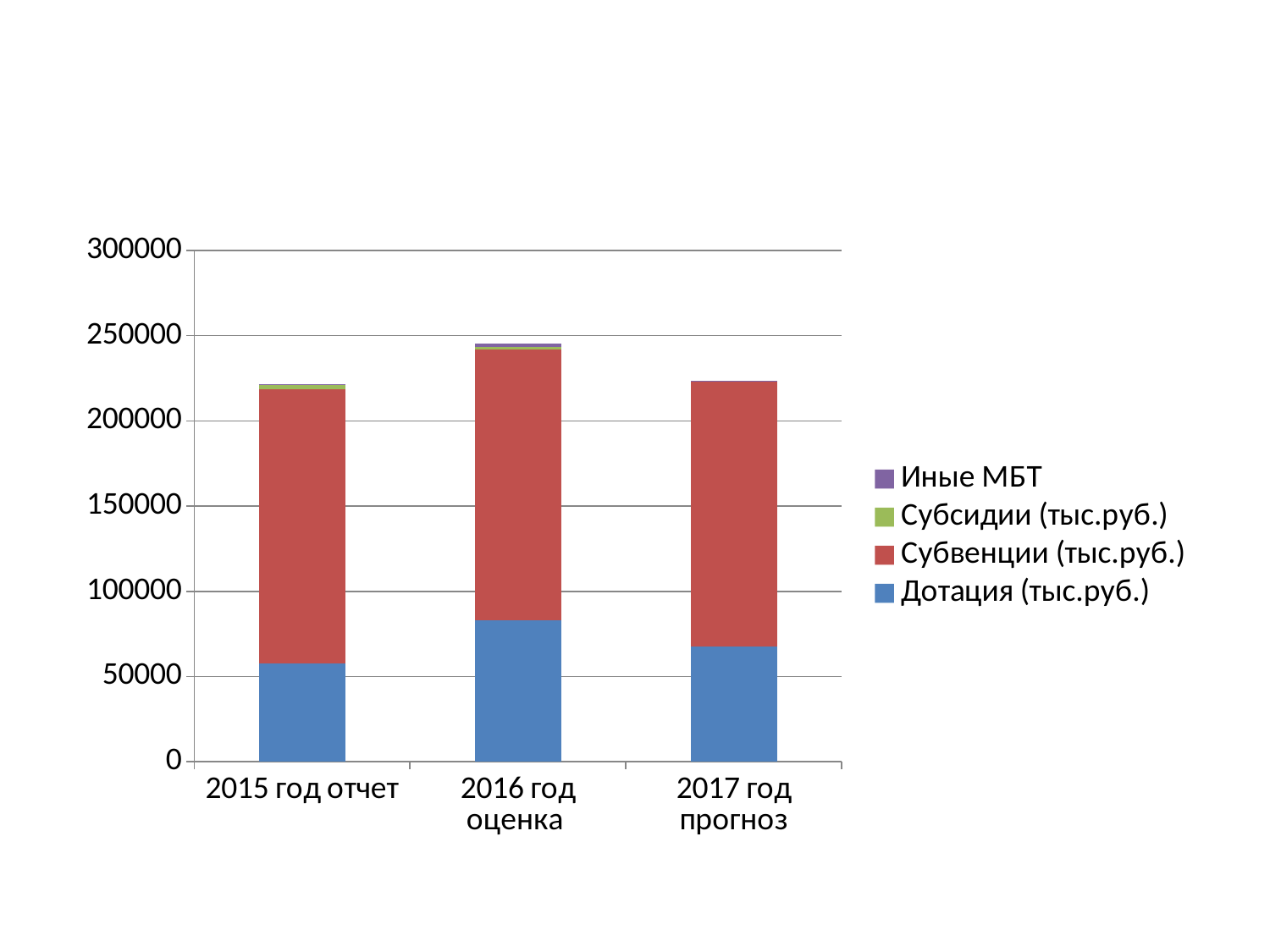
How many series does the legend list? 4 Is the Дотация (тыс.руб.) value for 2016 год оценка greater or less than 100000? less Is the Дотация (тыс.руб.) value for 2015 год отчет greater or less than 50000? greater How many categories are shown on the x axis? 3 Is the total stacked bar for 2016 год оценка greater or less than 250000? less Which category has the tallest stacked bar overall? 2016 год оценка Which category has the largest Дотация (тыс.руб.) segment? 2016 год оценка Which is larger: the Дотация (тыс.руб.) segment for 2016 год оценка or for 2017 год прогноз? 2016 год оценка Which category has the smallest Дотация (тыс.руб.) segment? 2015 год отчет Which series is shown in red in the chart? Субвенции (тыс.руб.) What kind of chart is shown on the slide? Stacked bar chart